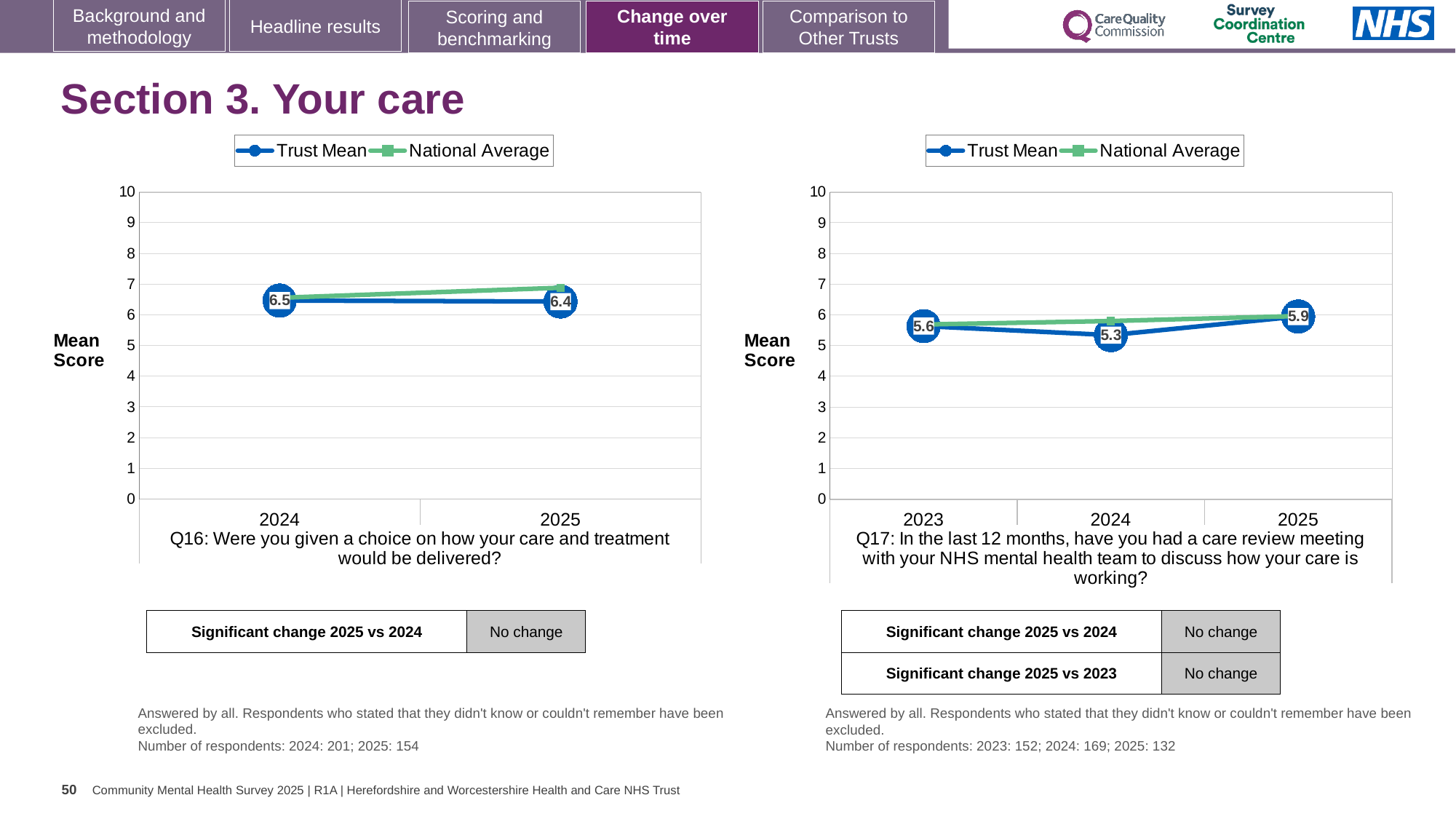
In the Q16 chart on the left, is the Trust Mean for 2024 or for 2025 larger? 2024 In the Q17 chart on the right, which year has the highest Trust Mean? 2025 In the Q17 chart on the right, is the Trust Mean for 2023 greater or less than 6? less In the Q16 chart on the left, how many series does the legend list? 2 What kind of chart is the Q17 chart on the right? Line chart In the Q17 chart on the right, what is the difference between the Trust Mean for 2025 and the Trust Mean for 2024? 0.6 In the Q17 chart on the right, which year has the lowest Trust Mean? 2024 In the Q16 chart on the left, what is the Trust Mean for 2025? 6.4 In the Q17 chart on the right, what is the Trust Mean for 2025? 5.9 In the Q17 chart on the right, how many years are plotted on the x axis? 3 In the Q16 chart on the left, what is the Trust Mean for 2024? 6.5 In the Q17 chart on the right, what is the Trust Mean for 2024? 5.3